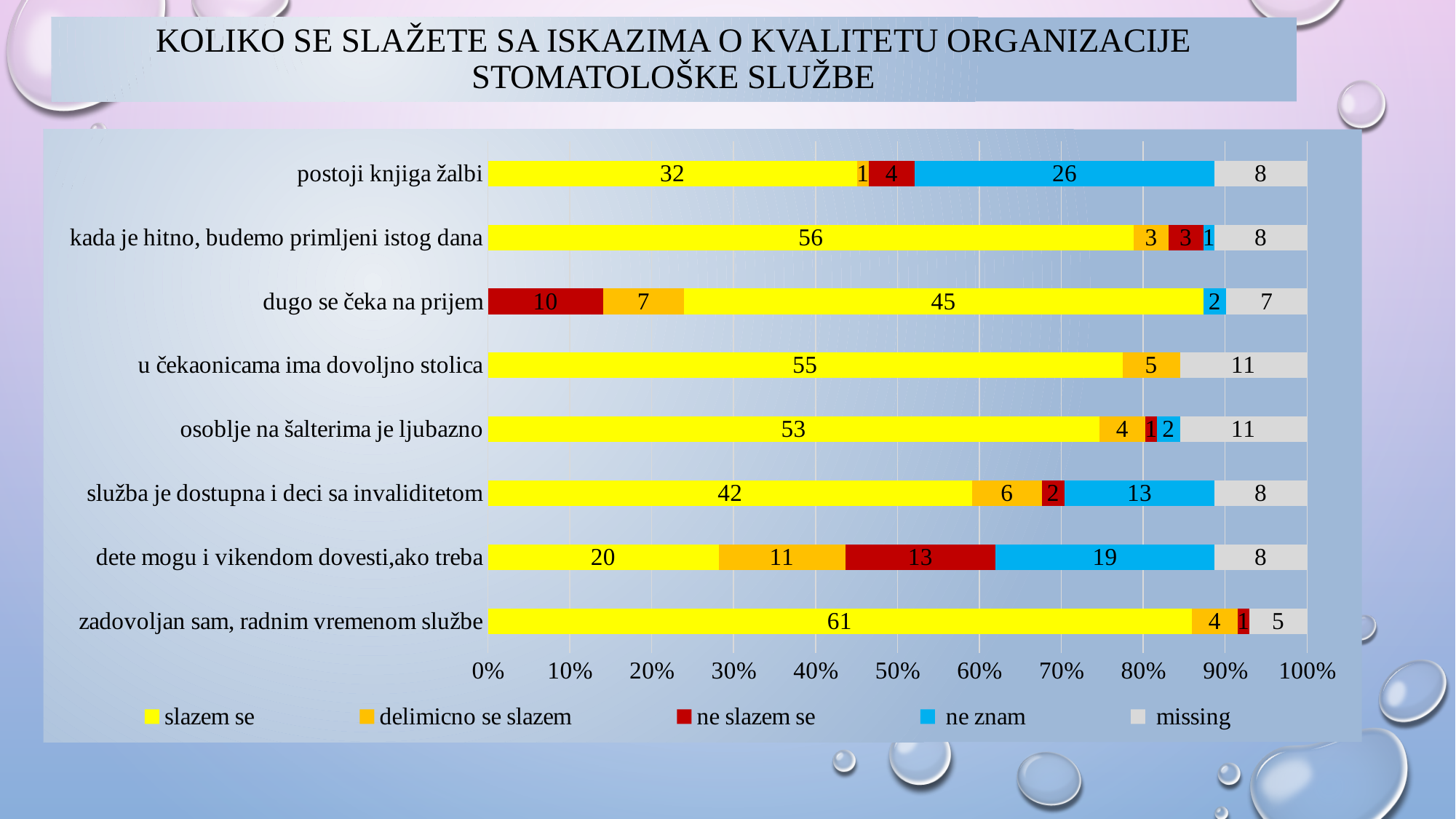
What is the total of the stacked bar for 'dete mogu i vikendom dovesti,ako treba'? 71 What is the 'missing' value for 'u čekaonicama ima dovoljno stolica'? 11 What is the difference between the 'slazem se' values for 'kada je hitno, budemo primljeni istog dana' and 'služba je dostupna i deci sa invaliditetom'? 14 Which is larger: the 'ne znam' value for 'postoji knjiga žalbi' or for 'služba je dostupna i deci sa invaliditetom'? postoji knjiga žalbi How many statements (categories) are plotted in the chart? 8 What is the 'slazem se' value for 'postoji knjiga žalbi'? 32 What is the 'ne slazem se' value for 'dugo se čeka na prijem'? 10 What is the 'ne znam' value for 'dete mogu i vikendom dovesti,ako treba'? 19 Which statement has the lowest 'slazem se' value? dete mogu i vikendom dovesti,ako treba How many series does the legend list? 5 Which statement has the highest 'slazem se' value? zadovoljan sam, radnim vremenom službe What kind of chart is shown on the slide? bar chart